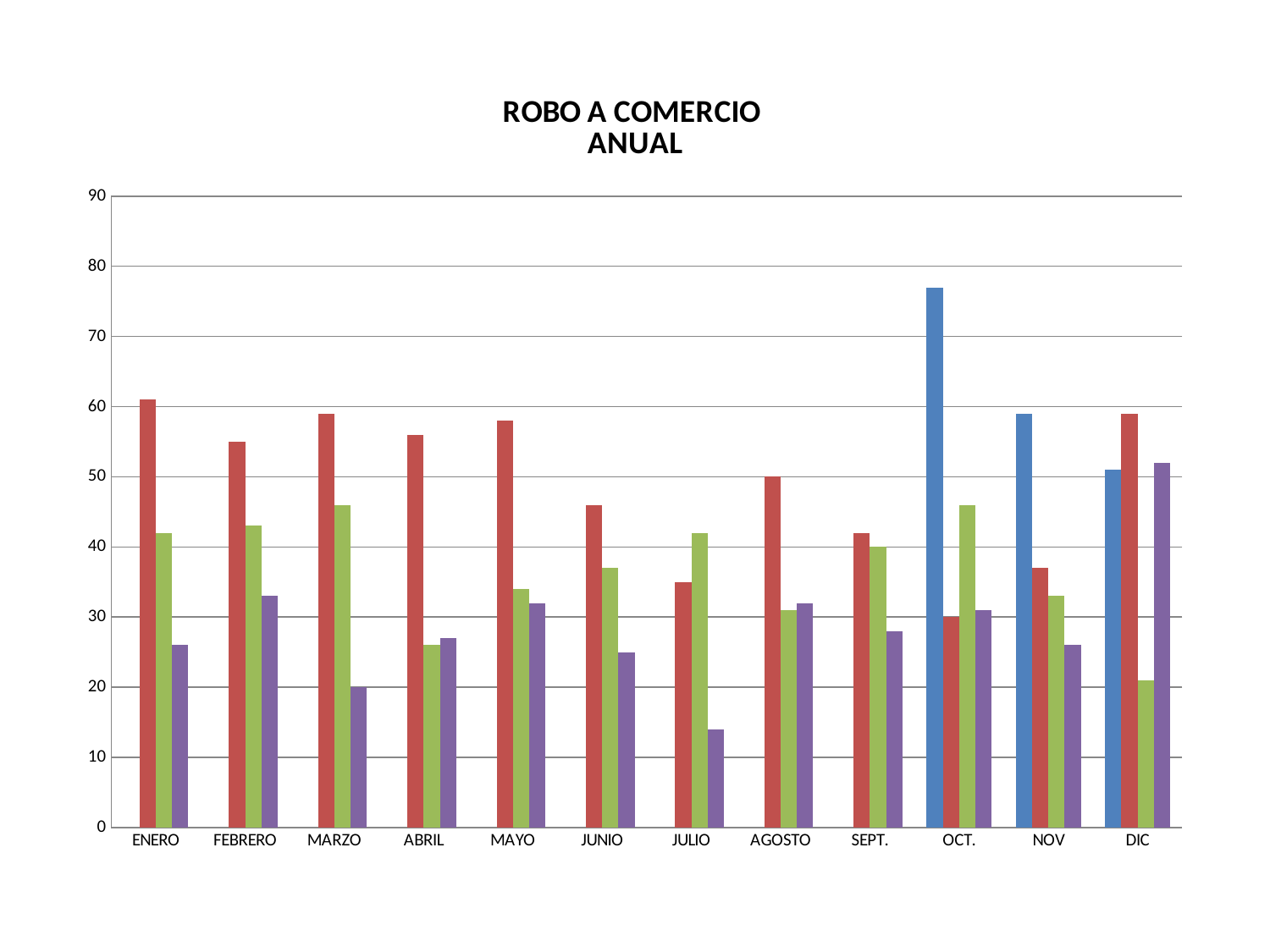
What is the title of the chart? ROBO A COMERCIO ANUAL How many months are shown along the x axis? 12 What kind of chart is shown on the slide? bar chart Is the purple bar for JULIO greater or less than 20? less Which month has the tallest bar in the chart? OCT. Which is larger, the red bar for ENERO or the red bar for JULIO? ENERO Is the blue bar for OCT. greater or less than 70? greater Which month has the shortest bar in the chart? JULIO Is the green bar for MARZO greater or less than 40? greater Do the red bars generally rise or fall from ENERO to JULIO? fall In DIC, which is larger, the purple bar or the green bar? purple